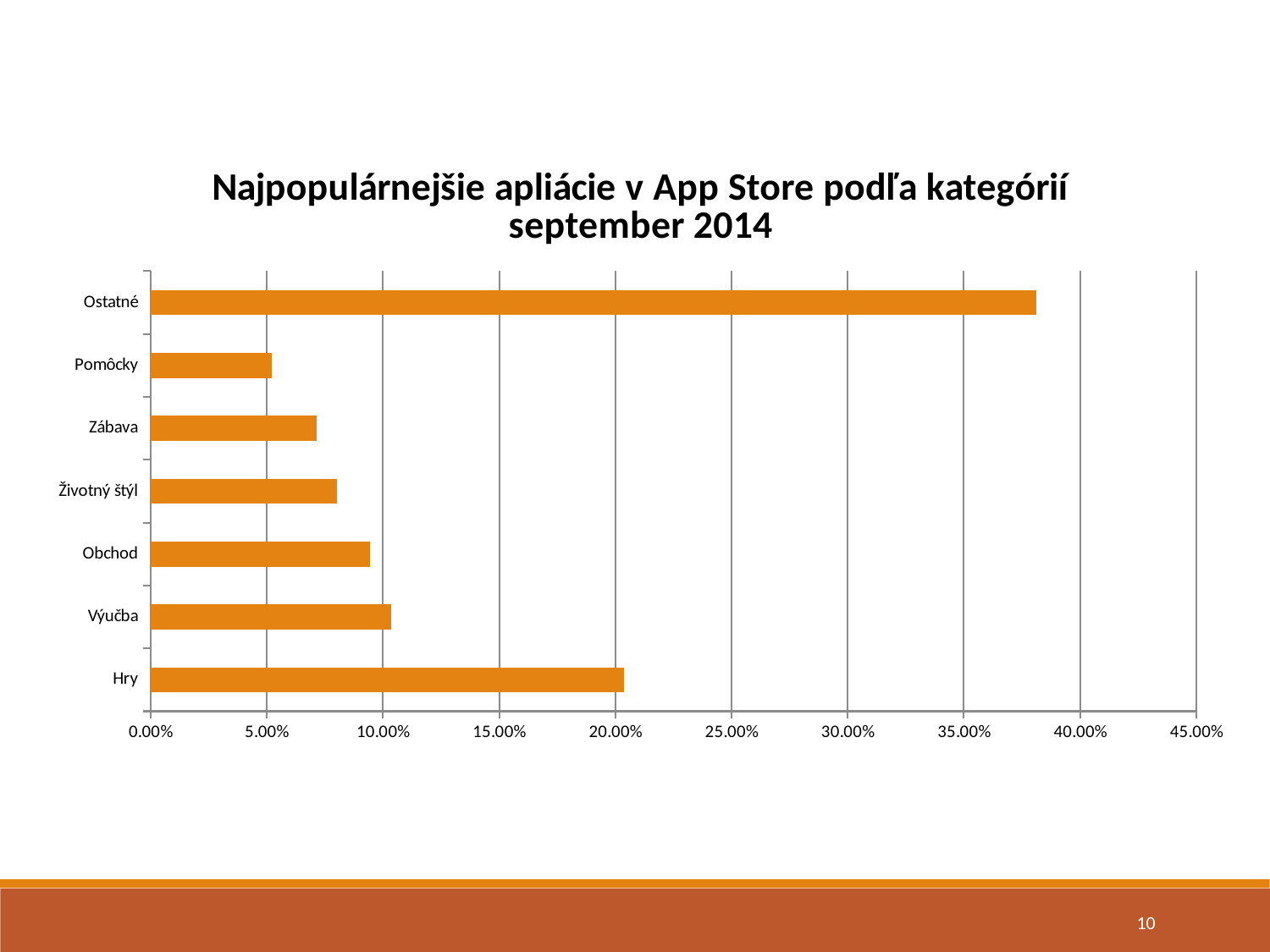
Which category has the highest value? Ostatné What kind of chart is shown on the slide? bar chart What is the title of the chart? Najpopulárnejšie apliácie v App Store podľa kategórií september 2014 Is the value for Ostatné greater or less than 35.00%? greater Is the value for Pomôcky greater or less than 10.00%? less Which is larger, the value for Hry or the value for Výučba? Hry How many categories are shown in the chart? 7 Is the value for Hry greater or less than 15.00%? greater Which category has the lowest value? Pomôcky Which is larger, the value for Obchod or the value for Zábava? Obchod